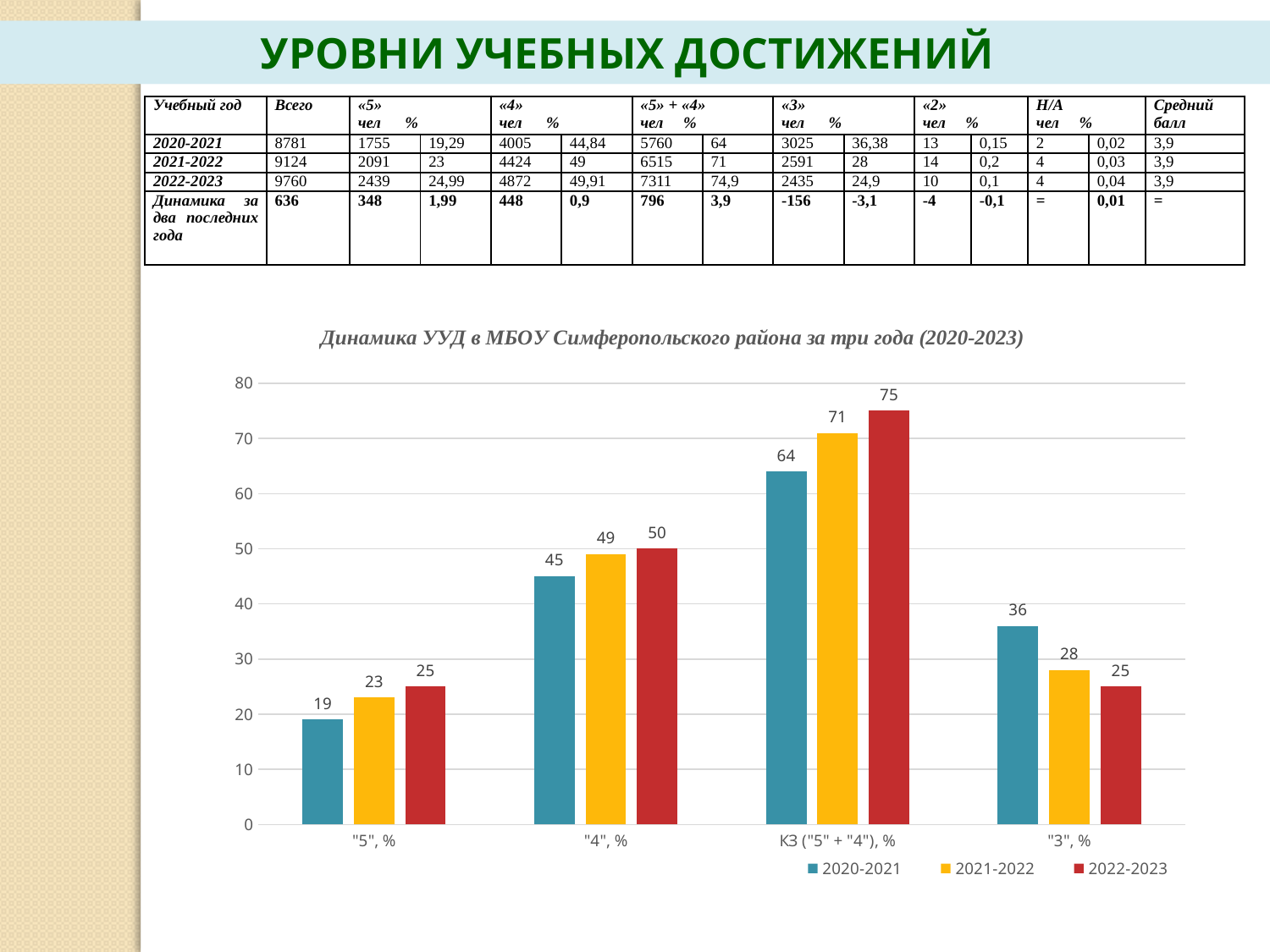
Do the values for "3", % rise or fall from 2020-2021 to 2022-2023? fall Which category has the lowest value in the 2022-2023 series? "5", % Which category has the highest value in the 2020-2021 series? КЗ ("5" + "4"), % What kind of chart is shown on the slide? bar chart What is the title of the chart? Динамика УУД в МБОУ Симферопольского района за три года (2020-2023) What is the value for КЗ ("5" + "4"), % in the 2022-2023 series? 75 How many categories are shown on the x axis? 4 For "3", %, which series has the larger value: 2020-2021 or 2022-2023? 2020-2021 What is the difference between the 2022-2023 and 2020-2021 values for КЗ ("5" + "4"), %? 11 What is the value for "3", % in the 2021-2022 series? 28 What is the value for "5", % in the 2020-2021 series? 19 How many series does the legend list? 3